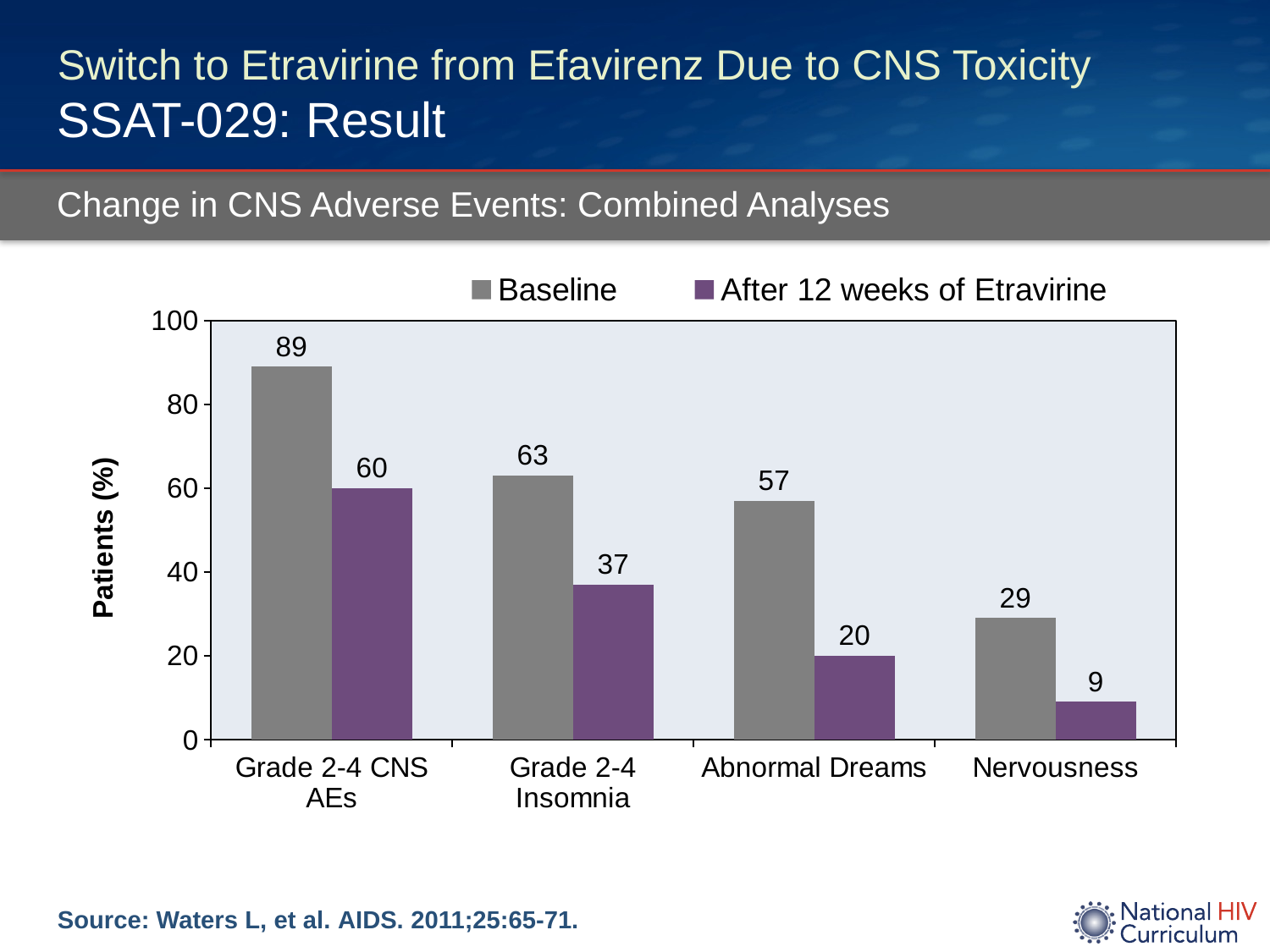
What is the difference between the Baseline and After 12 weeks of Etravirine values for Grade 2-4 Insomnia? 26 What is the Baseline value for Abnormal Dreams? 57 What is the Baseline value for Grade 2-4 CNS AEs? 89 Which is larger: the Baseline value for Abnormal Dreams or the After 12 weeks of Etravirine value for Grade 2-4 CNS AEs? After 12 weeks of Etravirine value for Grade 2-4 CNS AEs What is the value for Nervousness after 12 weeks of Etravirine? 9 Which category has the lowest value after 12 weeks of Etravirine? Nervousness Which category has the highest Baseline value? Grade 2-4 CNS AEs What kind of chart is shown on the slide? Bar chart Is the Baseline value for Nervousness greater or less than 40? less How many categories are shown on the x axis? 4 How many series does the legend list? 2 What is the label of the y axis? Patients (%)